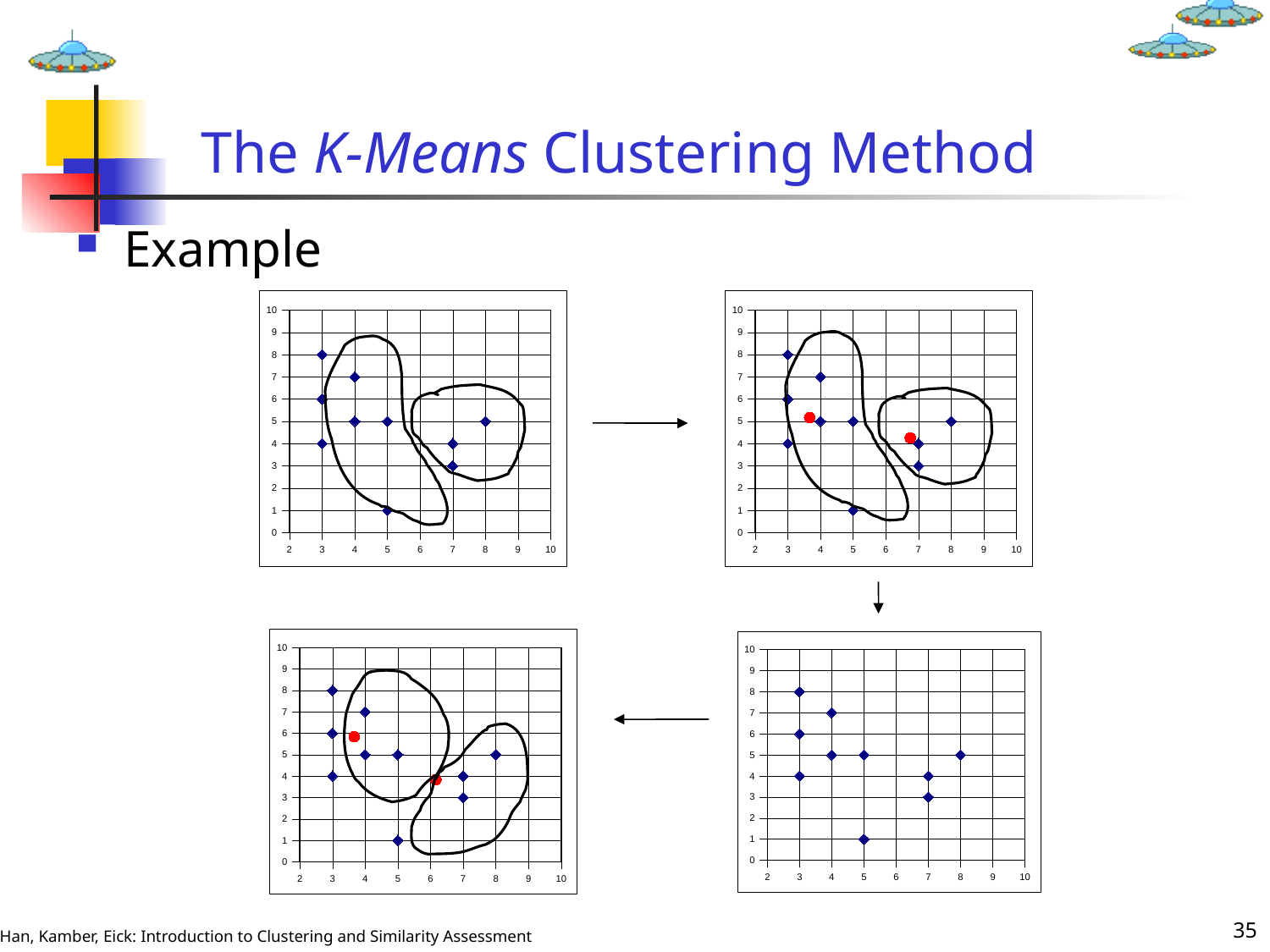
In the bottom-right chart, which has the larger y value: the point at x = 8 or the point at x = 5 with the lowest y? the point at x = 8 In the top-right chart, how many red centroid markers are shown? 2 In the bottom-right chart, what is the x value of the lowest plotted point? 5 What kind of chart is the top-left chart on the slide? scatter chart In the bottom-right chart, what is the difference in y value between the highest point and the lowest point? 7 In the bottom-right chart, is the y value of the point at x = 8 greater or less than 4? greater In the top-left chart, what is the highest value shown on the y axis? 10 How many data points are plotted in the bottom-right chart? 10 In the bottom-right chart, what is the y value of the lowest plotted point? 1 In the bottom-right chart, what is the y value of the highest plotted point? 8 In the bottom-right chart, what is the x value of the rightmost plotted point? 8 In the bottom-right chart, how many plotted points have a y value of 5? 3